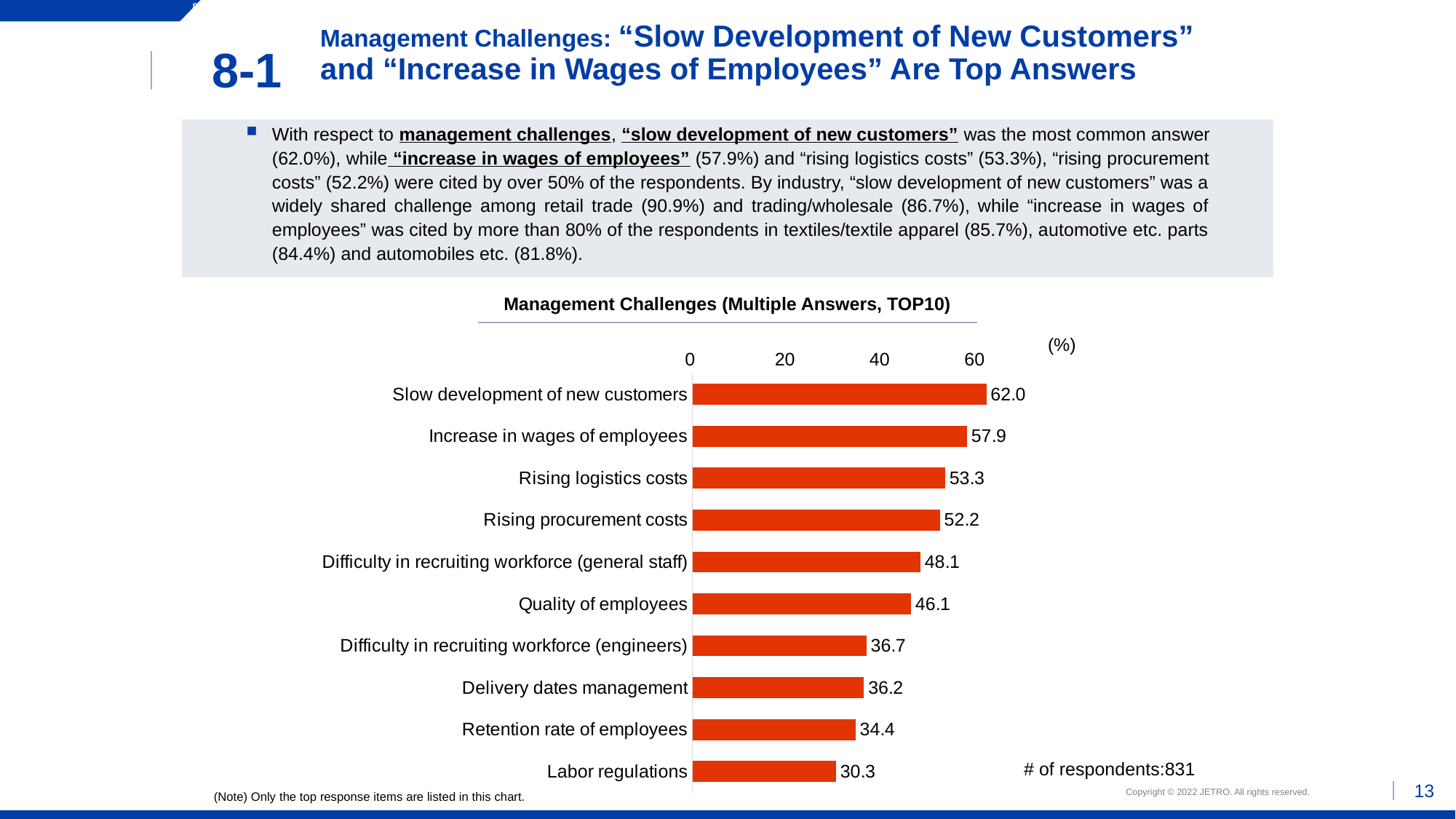
What is the title of the chart? Management Challenges (Multiple Answers, TOP10) What is the value for "Rising logistics costs"? 53.3 How many respondents does the chart note? 831 Which is larger: "Difficulty in recruiting workforce (general staff)" or "Difficulty in recruiting workforce (engineers)"? Difficulty in recruiting workforce (general staff) How many categories are shown in the chart? 10 What is the difference between "Slow development of new customers" and "Increase in wages of employees"? 4.1 What is the value for "Labor regulations"? 30.3 What is the value for "Quality of employees"? 46.1 Which category has the highest value? Slow development of new customers What kind of chart is shown on the slide? Bar chart Is the value for "Retention rate of employees" greater or less than 40? less Which category has the lowest value? Labor regulations